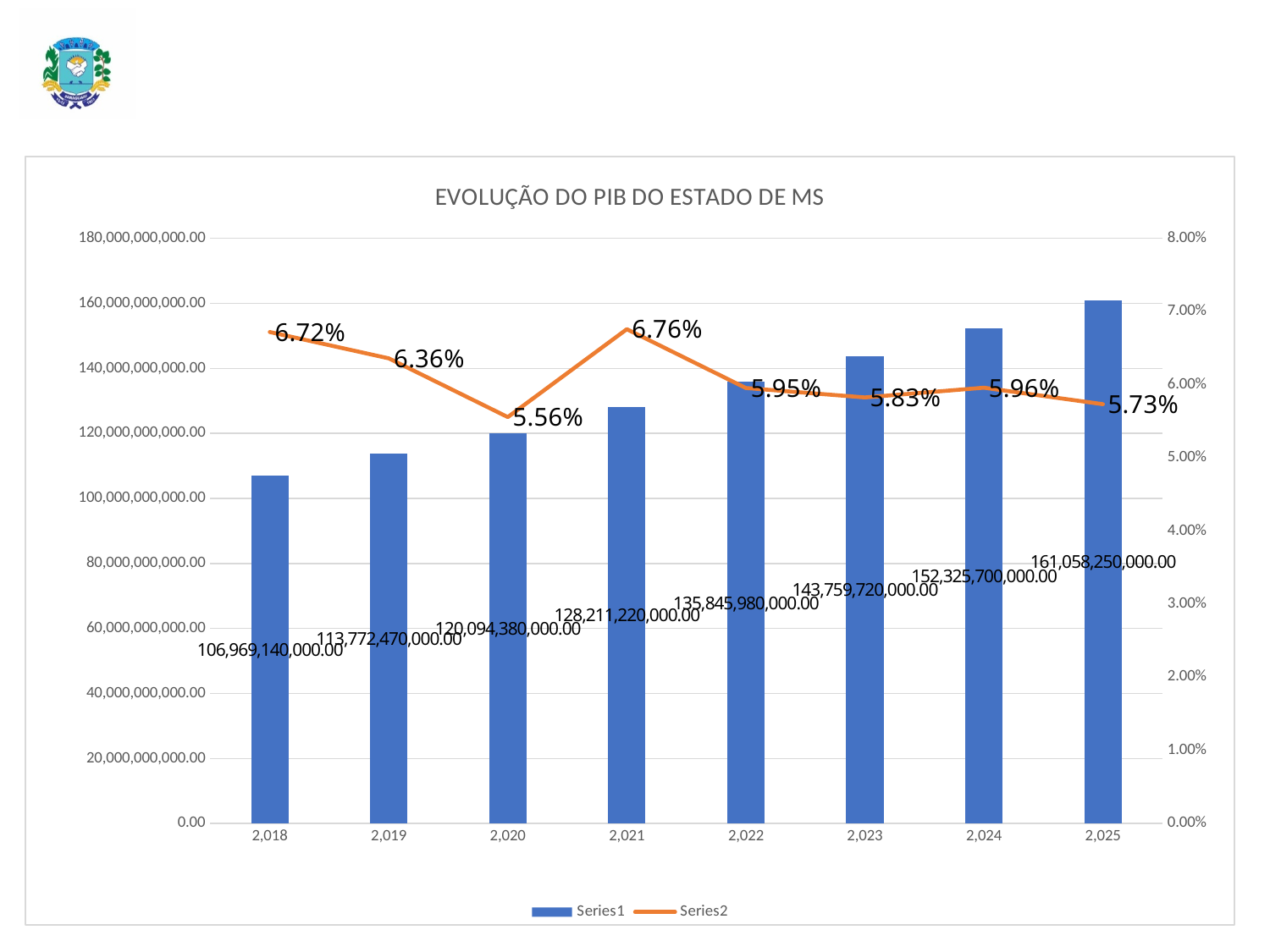
How many series does the legend list? 2 Which year has the lowest Series1 value? 2,018 Do the Series1 bar values rise or fall from 2,018 to 2,025? rise What is the difference between the highest and lowest Series2 values? 1.20% What is the title of the chart? EVOLUÇÃO DO PIB DO ESTADO DE MS What is the Series1 value for 2,025? 161,058,250,000.00 What is the Series2 value for 2,020? 5.56% What is the difference between the Series1 values for 2,025 and 2,018? 54,089,110,000.00 Which year has the highest Series2 value? 2,021 What is the Series1 value for 2,021? 128,211,220,000.00 How many years are shown on the x axis? 8 Which is larger, the Series2 value for 2,022 or for 2,023? 2,022